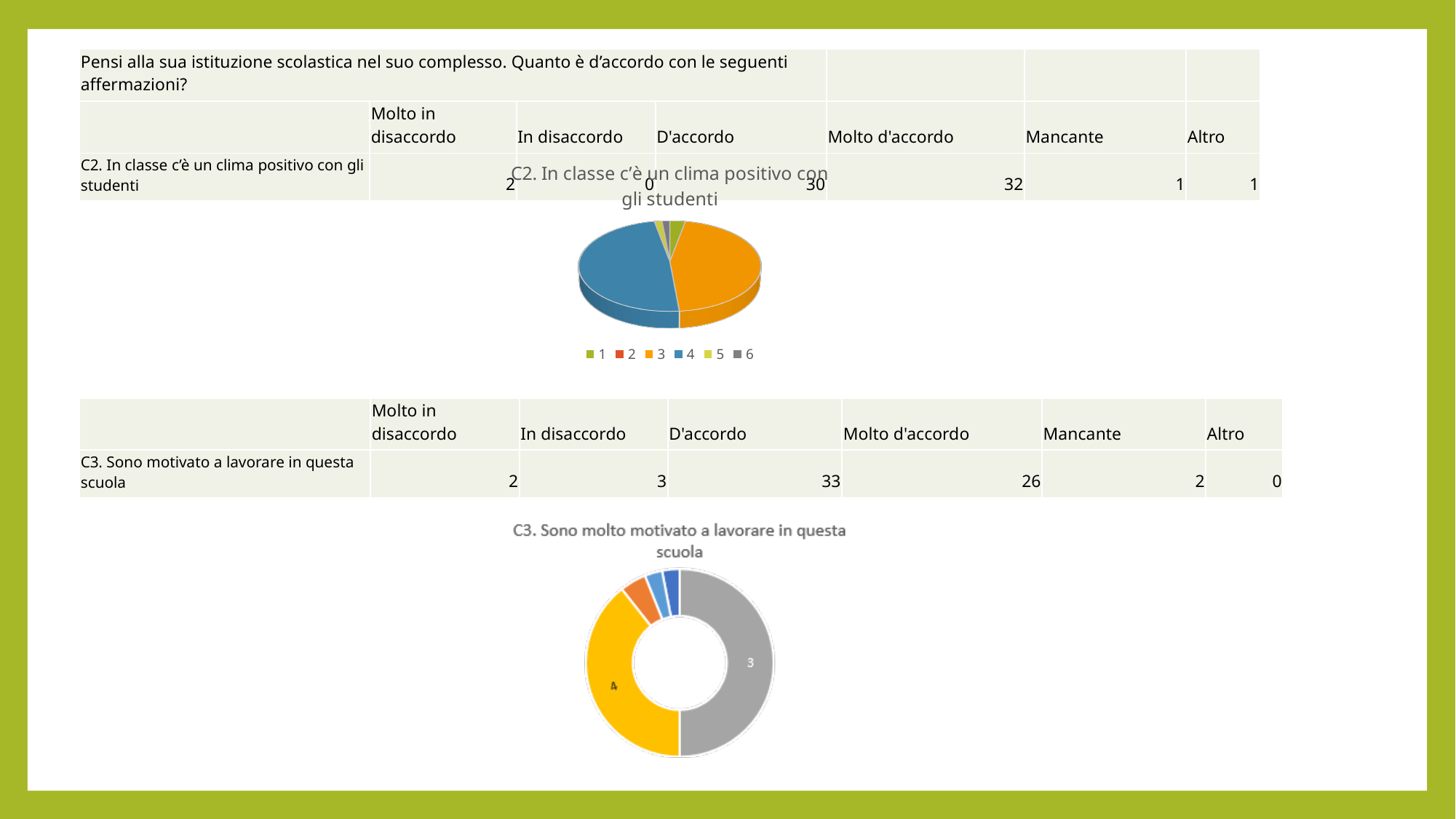
How many slices are visible in the bottom doughnut chart? 5 What kind of chart is the bottom chart titled "C3. Sono molto motivato a lavorare in questa scuola"? doughnut chart In the bottom doughnut chart, which slice is the largest? 3 What is the title of the bottom doughnut chart? C3. Sono molto motivato a lavorare in questa scuola In the bottom doughnut chart, which labelled slice is larger, "3" or "4"? 3 How many slices are visible in the top pie chart? 5 What kind of chart is the top chart titled "C2. In classe c'è un clima positivo con gli studenti"? pie chart How many entries does the legend of the top pie chart list? 6 What is the title of the top pie chart? C2. In classe c'è un clima positivo con gli studenti